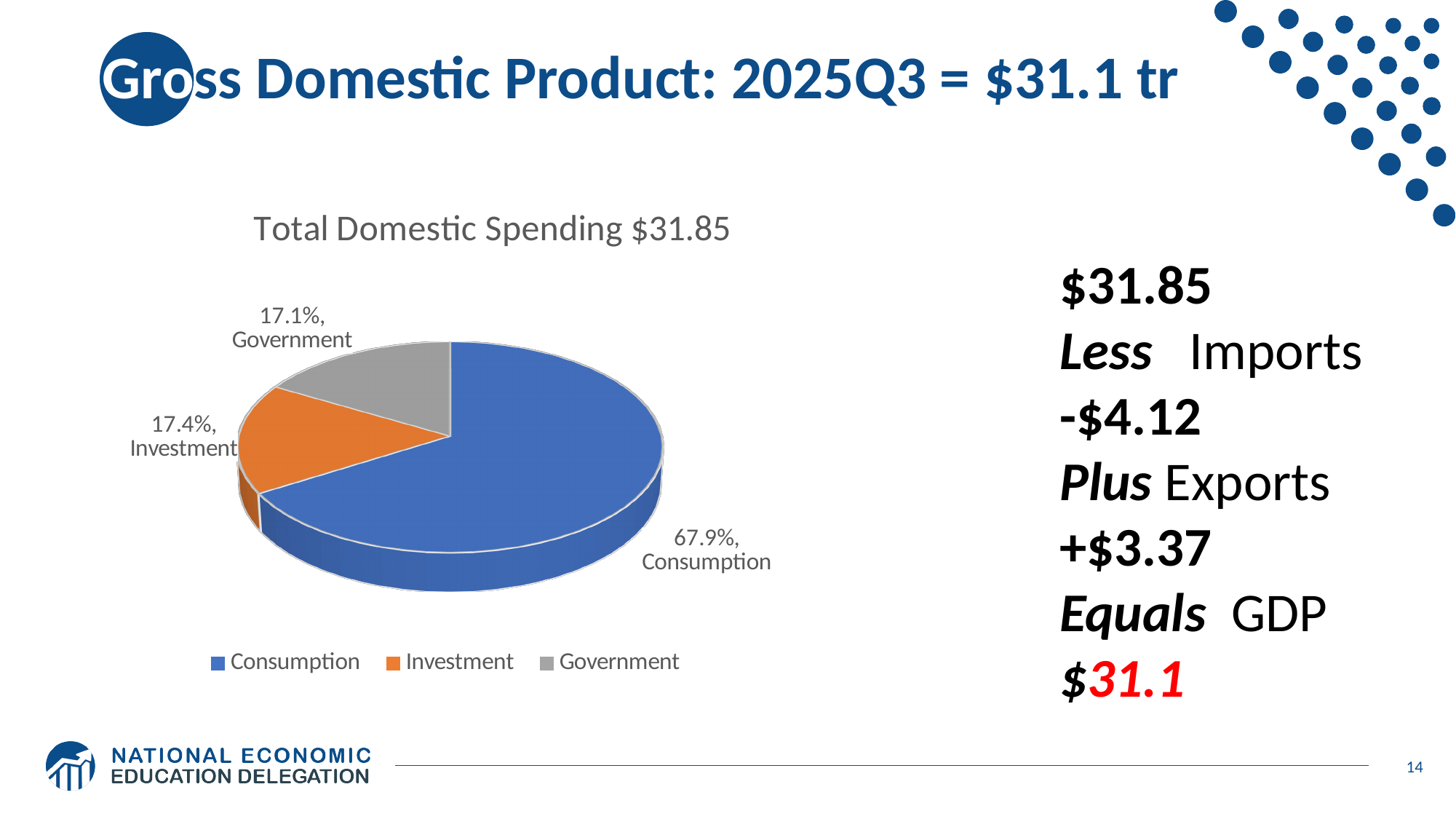
How many entries does the legend list? 3 What is the difference in percentage points between the Investment share and the Government share? 0.3 What share of the pie does Investment represent? 17.4% How many categories does the pie chart show? 3 What share of the pie does Government represent? 17.1% Which category has the largest slice of the pie? Consumption What is the difference in percentage points between the Consumption share and the Investment share? 50.5 Is the Consumption share greater or less than 50%? greater Which colour represents Investment in the pie chart? Orange What share of the pie does Consumption represent? 67.9% What is the title of the chart? Total Domestic Spending $31.85 What type of chart is shown on the slide? Pie chart